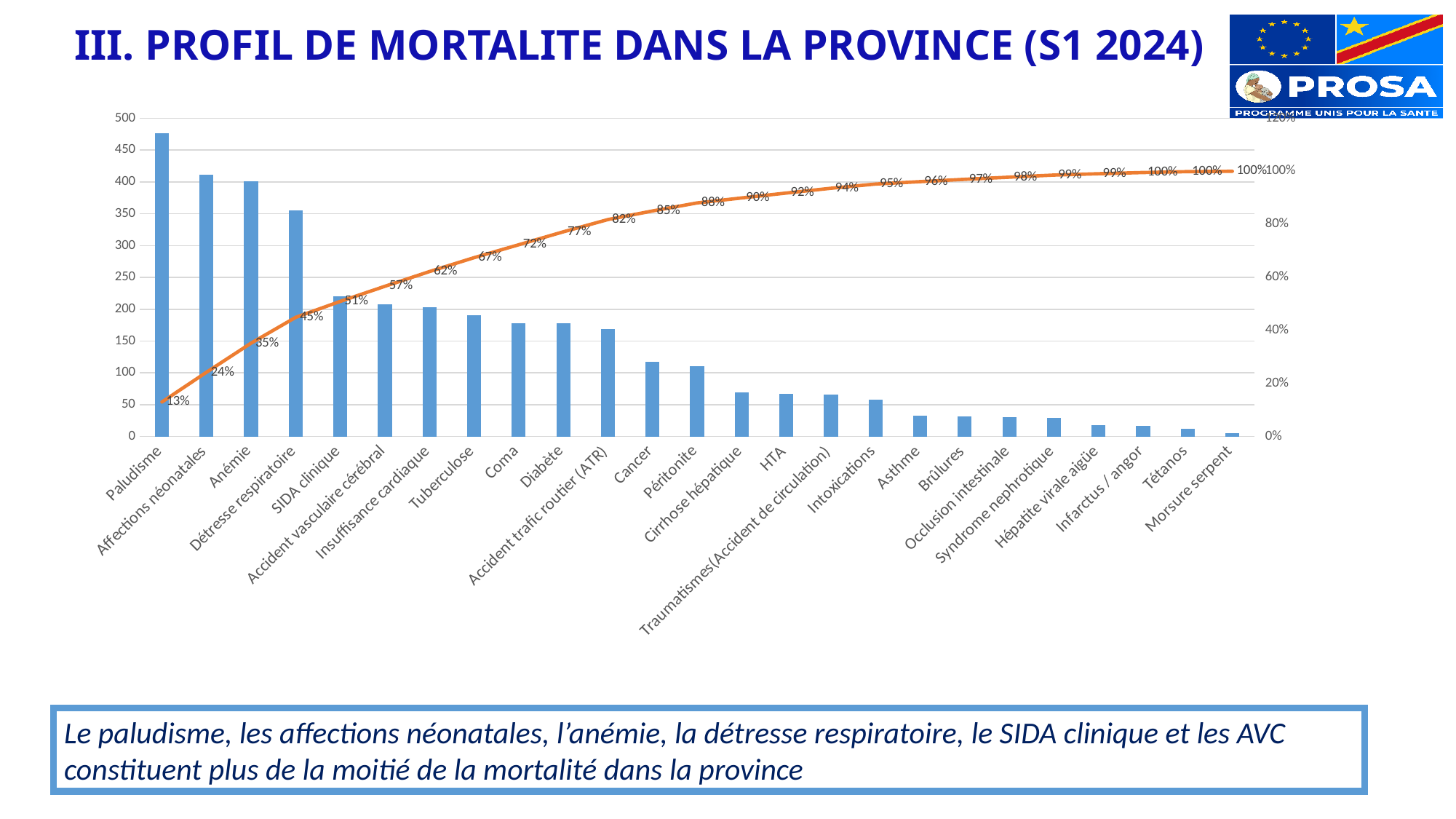
Which cause of death has the highest bar? Paludisme Is the bar value for Coma greater or less than 200? less What is the cumulative percentage shown at Cancer? 85% By how many percentage points does the cumulative percentage rise from Paludisme to Anémie? 22 percentage points How many causes of death are shown on the x axis? 25 Which has a higher bar, Tuberculose or Cancer? Tuberculose Is the bar value for Paludisme greater or less than 450? greater Which cause of death has the lowest bar? Morsure serpent What is the cumulative percentage shown at Tuberculose? 67% Do the bar values rise or fall from left to right along the x axis? fall What is the cumulative percentage shown at SIDA clinique? 51% What is the cumulative percentage shown for Paludisme? 13%